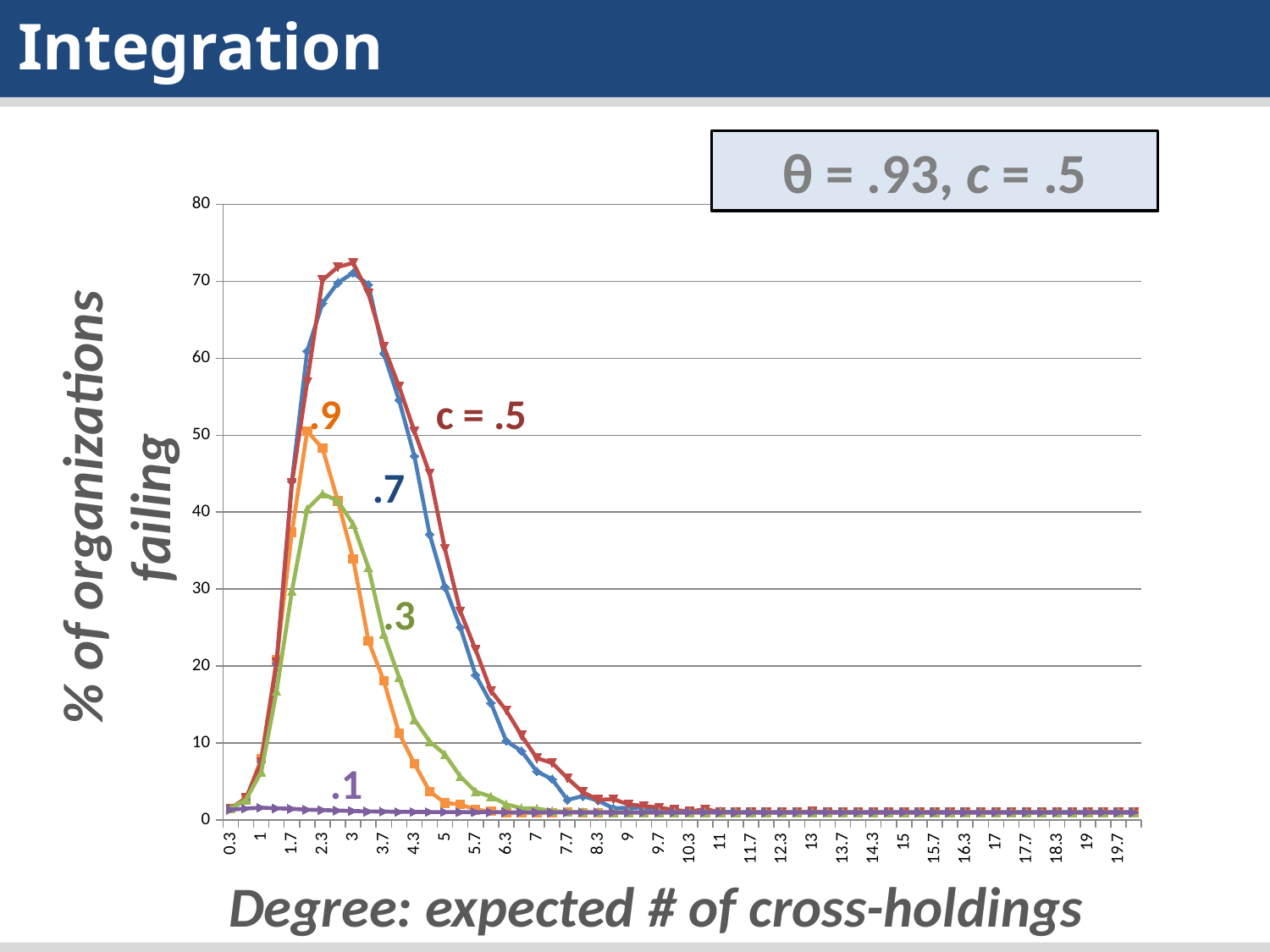
After degree 3, do the values of the c = .5 curve rise or fall as degree increases? fall Is the peak value of the .9 curve greater or less than 40? greater Is the peak value of the c = .5 curve greater or less than 60? greater What is the title of the y axis? % of organizations failing How many curves (values of c) are plotted on the chart? 5 What kind of chart is shown on the slide? line chart Is the peak value of the .3 curve greater or less than 50? less Which curve stays lowest across all degrees? .1 Which curve reaches a higher peak: .9 or .3? .9 What is the title of the x axis? Degree: expected # of cross-holdings At degree 3, which curve is higher: .7 or .3? .7